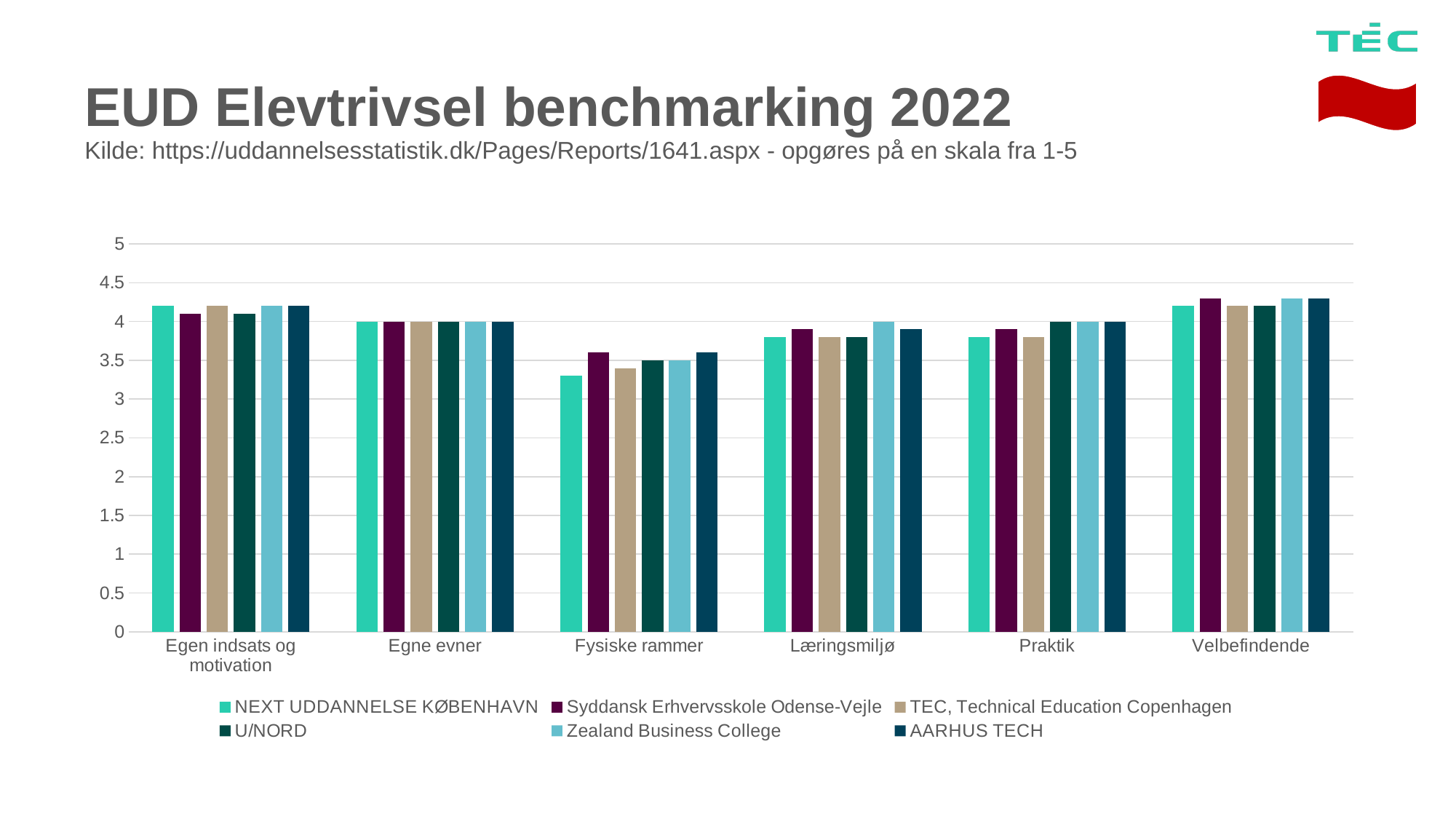
In Fysiske rammer, which is larger: the value for NEXT UDDANNELSE KØBENHAVN or for Syddansk Erhvervsskole Odense-Vejle? Syddansk Erhvervsskole Odense-Vejle How many series does the chart's legend list? 6 In Læringsmiljø, which is larger: the value for Zealand Business College or for TEC, Technical Education Copenhagen? Zealand Business College What kind of chart is shown on the slide? bar chart What is the title of the slide containing the chart? EUD Elevtrivsel benchmarking 2022 Is the value for NEXT UDDANNELSE KØBENHAVN in Fysiske rammer greater or less than 3.5? less How many categories are shown along the x axis of the chart? 6 Is the value for TEC, Technical Education Copenhagen in Praktik greater or less than 4? less In which category does Syddansk Erhvervsskole Odense-Vejle have its highest value? Velbefindende Is the value for Syddansk Erhvervsskole Odense-Vejle in Velbefindende greater or less than 4? greater In which category does NEXT UDDANNELSE KØBENHAVN have its lowest value? Fysiske rammer Which series is listed first in the chart's legend? NEXT UDDANNELSE KØBENHAVN